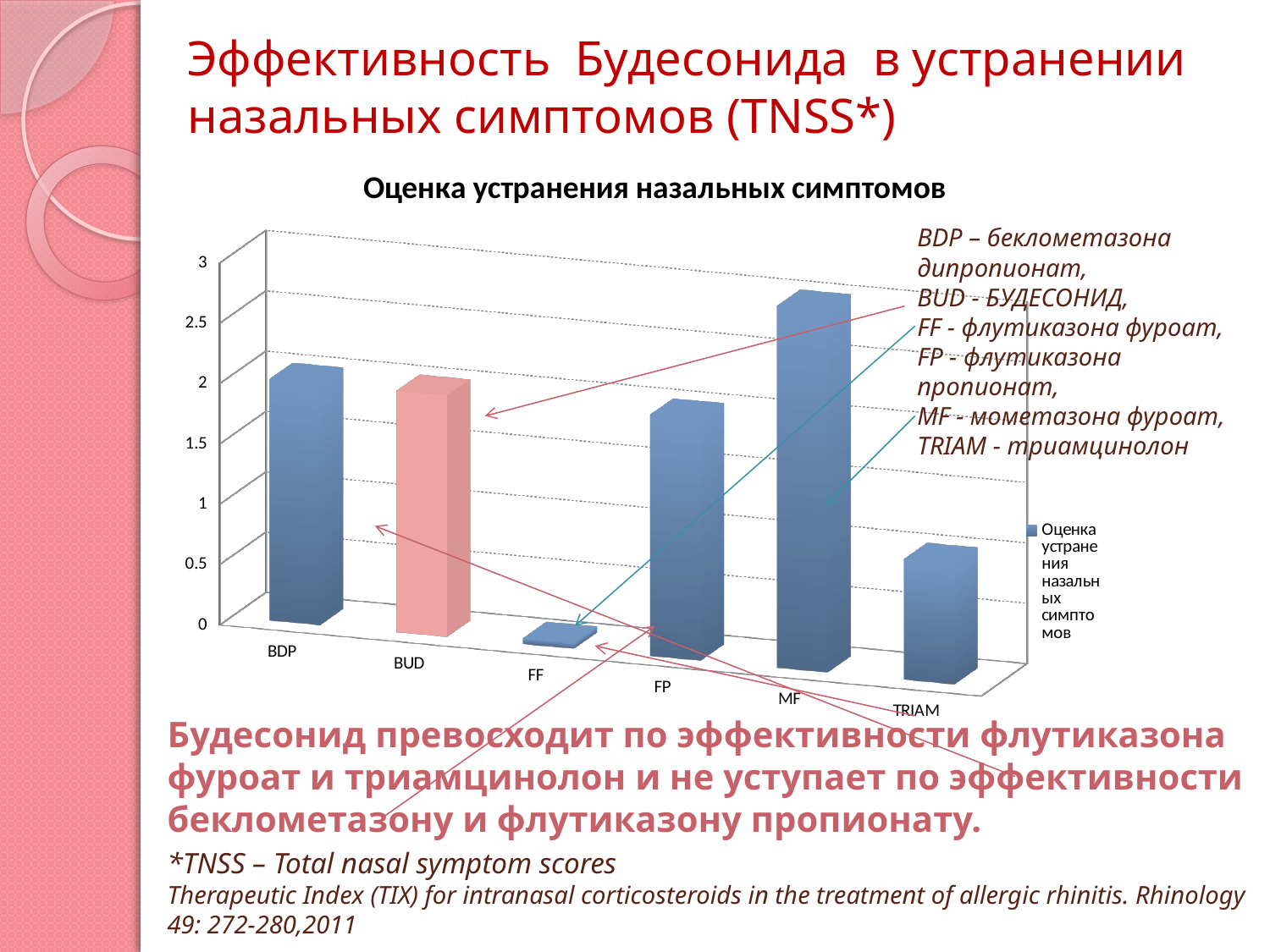
What is the title of the chart? Оценка устранения назальных симптомов Which has the larger value, BUD or TRIAM? BUD Which category has the highest bar in the chart? MF Is the value for MF greater or less than 2? greater Which category has the lowest bar in the chart? FF Is the value for BDP greater or less than 1.5? greater What kind of chart is shown on the slide? bar chart How many categories are plotted on the x axis of the chart? 6 Is the value for TRIAM greater or less than 1.5? less How many series does the chart legend list? 1 Which bar in the chart is coloured differently (pink) from the others? BUD